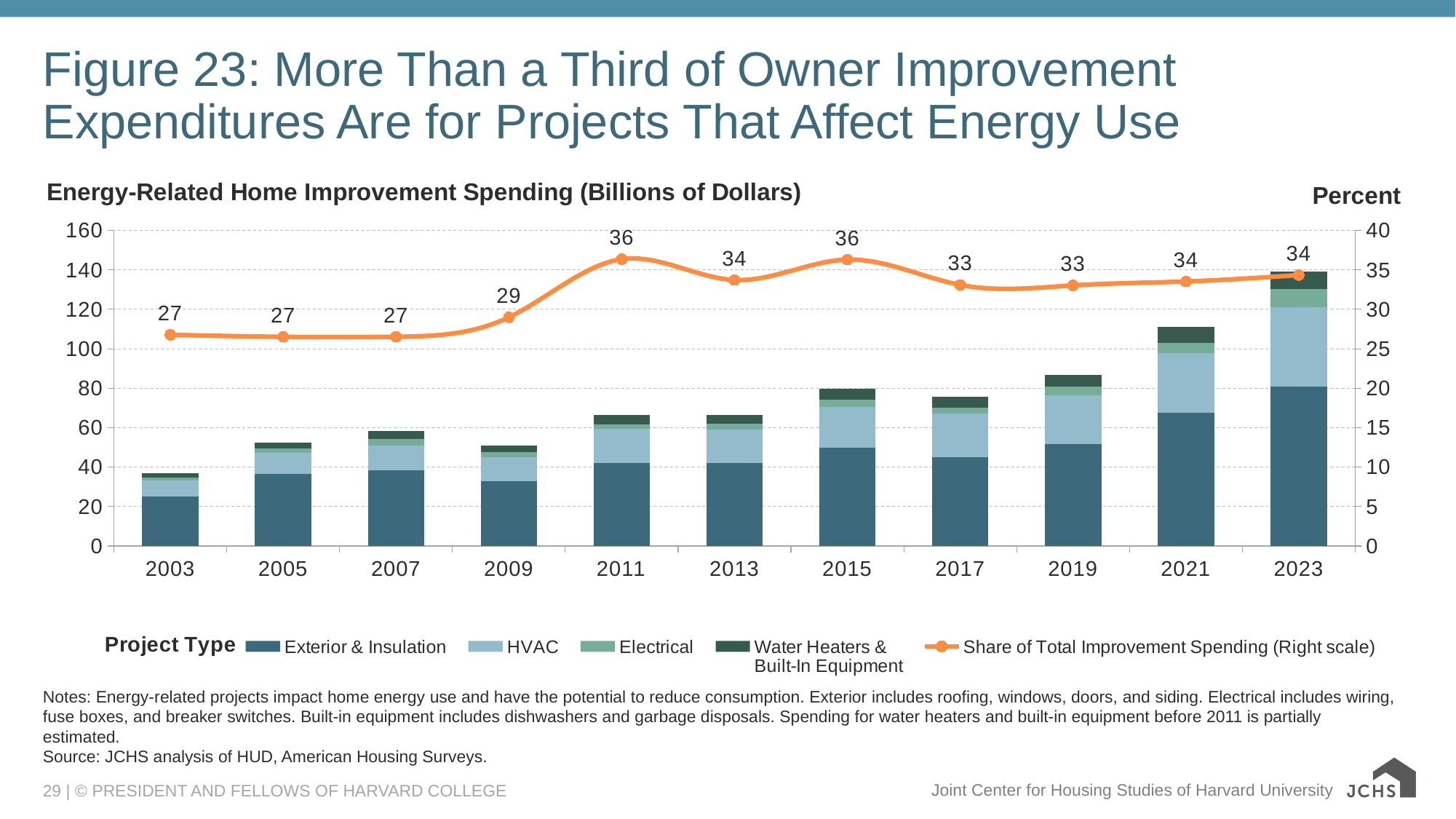
What is the Share of Total Improvement Spending for 2003? 27 Is the total energy-related spending bar for 2003 greater or less than 40 billion dollars? less Is the total energy-related spending bar for 2023 greater or less than 120 billion dollars? greater What is the Share of Total Improvement Spending for 2023? 34 Which year has the tallest stacked bar for energy-related home improvement spending? 2023 How many years are shown on the x axis? 11 What is the Share of Total Improvement Spending for 2011? 36 Does the Share of Total Improvement Spending rise or fall from 2003 to 2011? rise By how many percentage points did the Share of Total Improvement Spending change from 2003 to 2011? 9 How many series does the legend list? 5 Which year has the shortest stacked bar for energy-related home improvement spending? 2003 What is the Share of Total Improvement Spending for 2009? 29